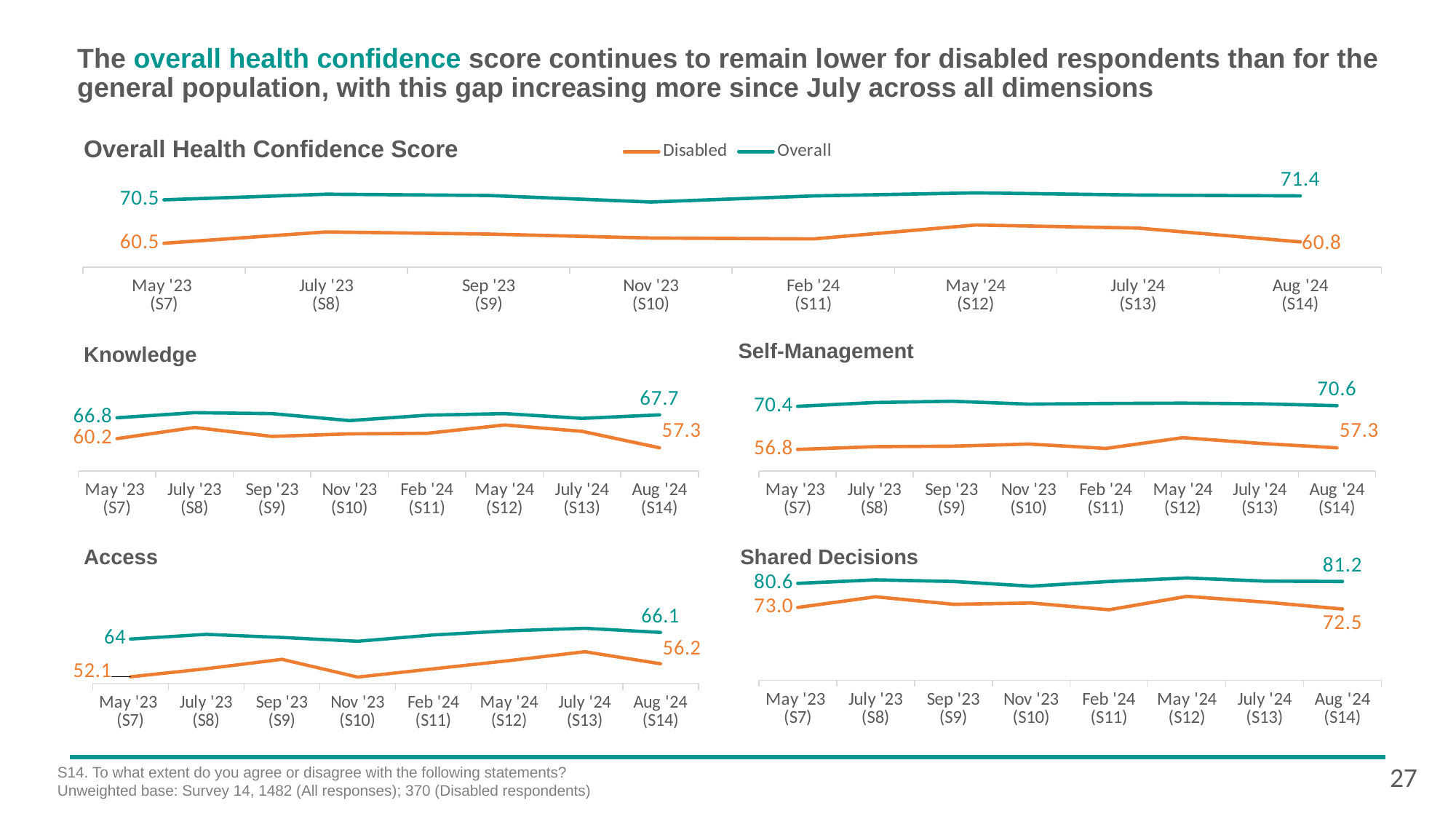
In the Overall Health Confidence Score chart, what is the difference between the Overall and Disabled values at Aug '24 (S14)? 10.6 How many series does the legend of the Overall Health Confidence Score chart list? 2 In the Knowledge chart, what is the Disabled value for Aug '24 (S14)? 57.3 In the Access chart, what is the Disabled value for May '23 (S7)? 52.1 In the Shared Decisions chart, which is larger at May '23 (S7): the Overall value or the Disabled value? Overall In the Access chart, what is the difference between the Disabled values at Aug '24 (S14) and May '23 (S7)? 4.1 In the Overall Health Confidence Score chart, what is the Overall value for Aug '24 (S14)? 71.4 In the Knowledge chart, did the Disabled value rise or fall from May '23 (S7) to Aug '24 (S14)? fall In the Shared Decisions chart, what is the Overall value for Aug '24 (S14)? 81.2 In the Self-Management chart, what is the Overall value for May '23 (S7)? 70.4 In the Overall Health Confidence Score chart, what is the Disabled value for May '23 (S7)? 60.5 How many time points are shown on the x axis of the Overall Health Confidence Score chart? 8